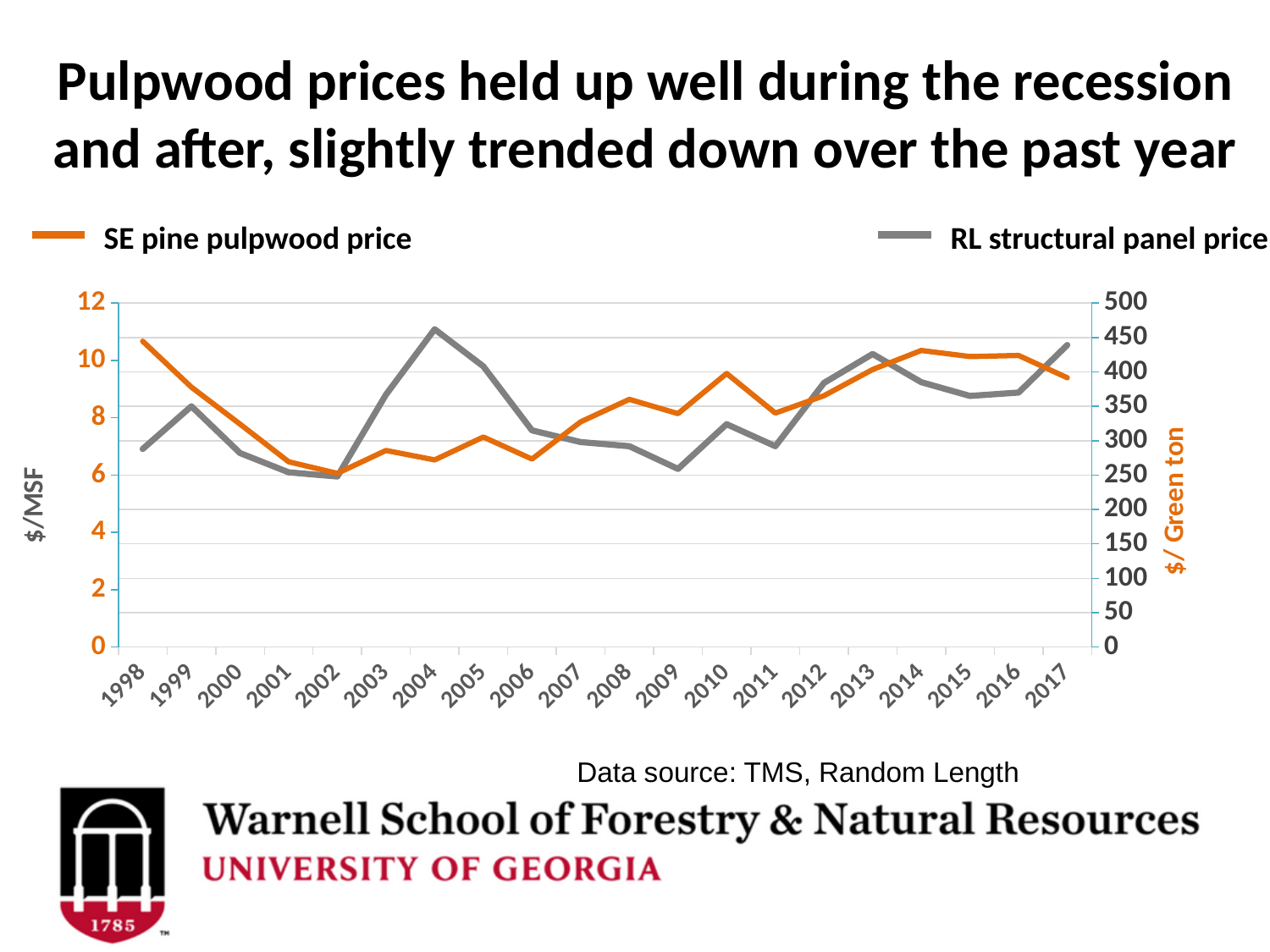
In which year does the RL structural panel price reach its highest point? 2004 How many series does the legend list? 2 What kind of chart is shown on the slide? line chart Does the SE pine pulpwood price rise or fall from 2014 to 2017? fall Which is higher, the RL structural panel price in 2004 or in 2009? 2004 How many years are plotted along the x axis? 20 Is the SE pine pulpwood price in 2002 greater or less than 300 $/Green ton? less Is the RL structural panel price in 2004 greater or less than 10 $/MSF? greater Which is higher, the SE pine pulpwood price in 2014 or in 2002? 2014 What is the label on the left vertical axis? $/MSF